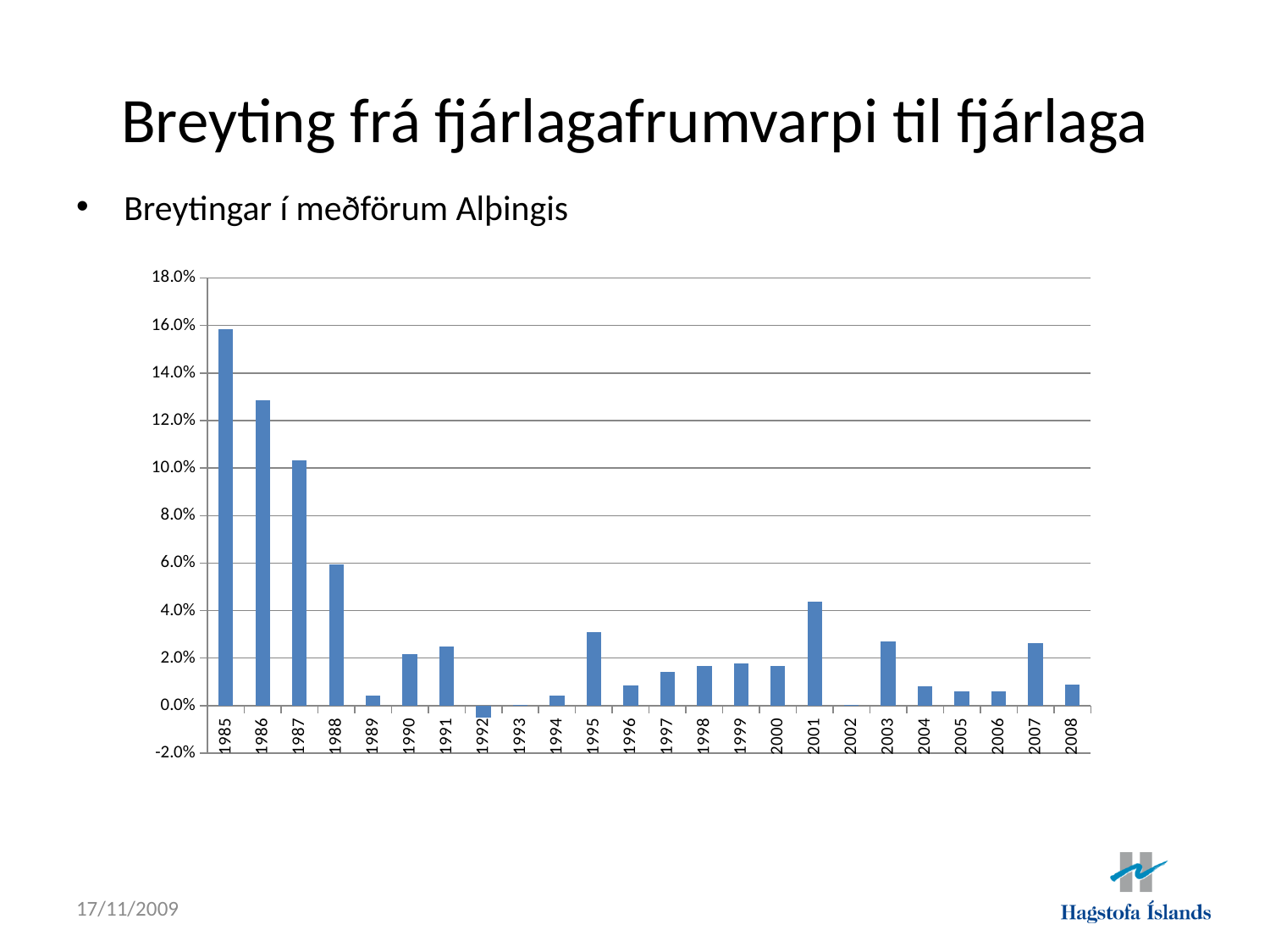
Is the value for 1989 greater or less than 2.0%? less How many years are shown on the x axis of the chart? 24 Do the values rise or fall from 1985 to 1988? fall Is the value for 1986 greater or less than 12.0%? greater Which year has the lowest value in the chart? 1992 What kind of chart is shown on the slide? bar chart Which year has the larger value, 1985 or 1986? 1985 Is the value for 1987 greater or less than 10.0%? greater Which year has the larger value, 2001 or 1995? 2001 Which year has the highest value in the chart? 1985